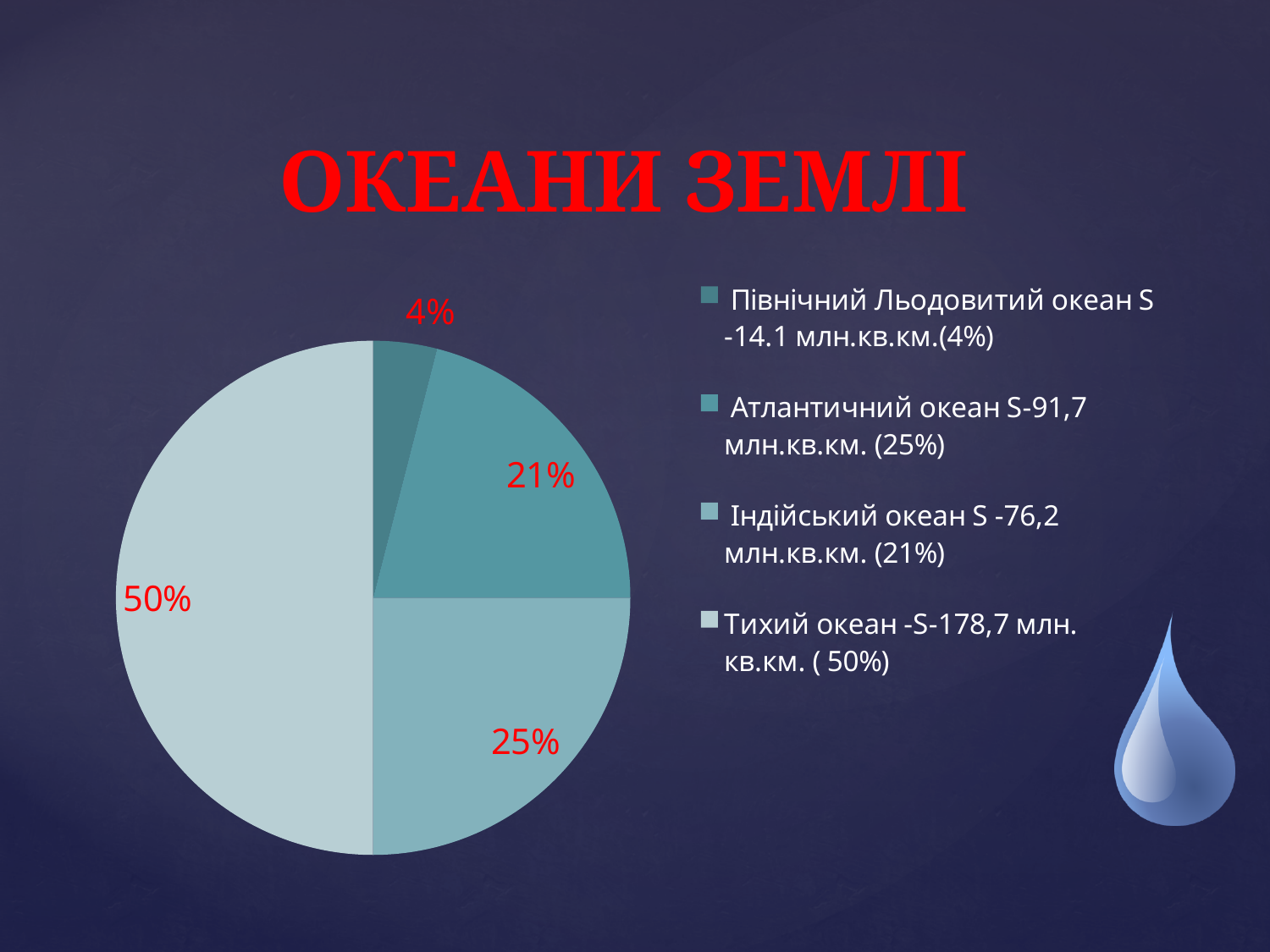
What kind of chart is shown on the slide? pie chart What is the title of the slide containing the pie chart? ОКЕАНИ ЗЕМЛІ What share of the pie does Тихий океан have? 50% Which ocean has the largest slice of the pie? Тихий океан Which ocean has the smallest slice of the pie? Північний Льодовитий океан What share of the pie does Північний Льодовитий океан have? 4% How many entries does the legend list? 4 How many slices does the pie chart have? 4